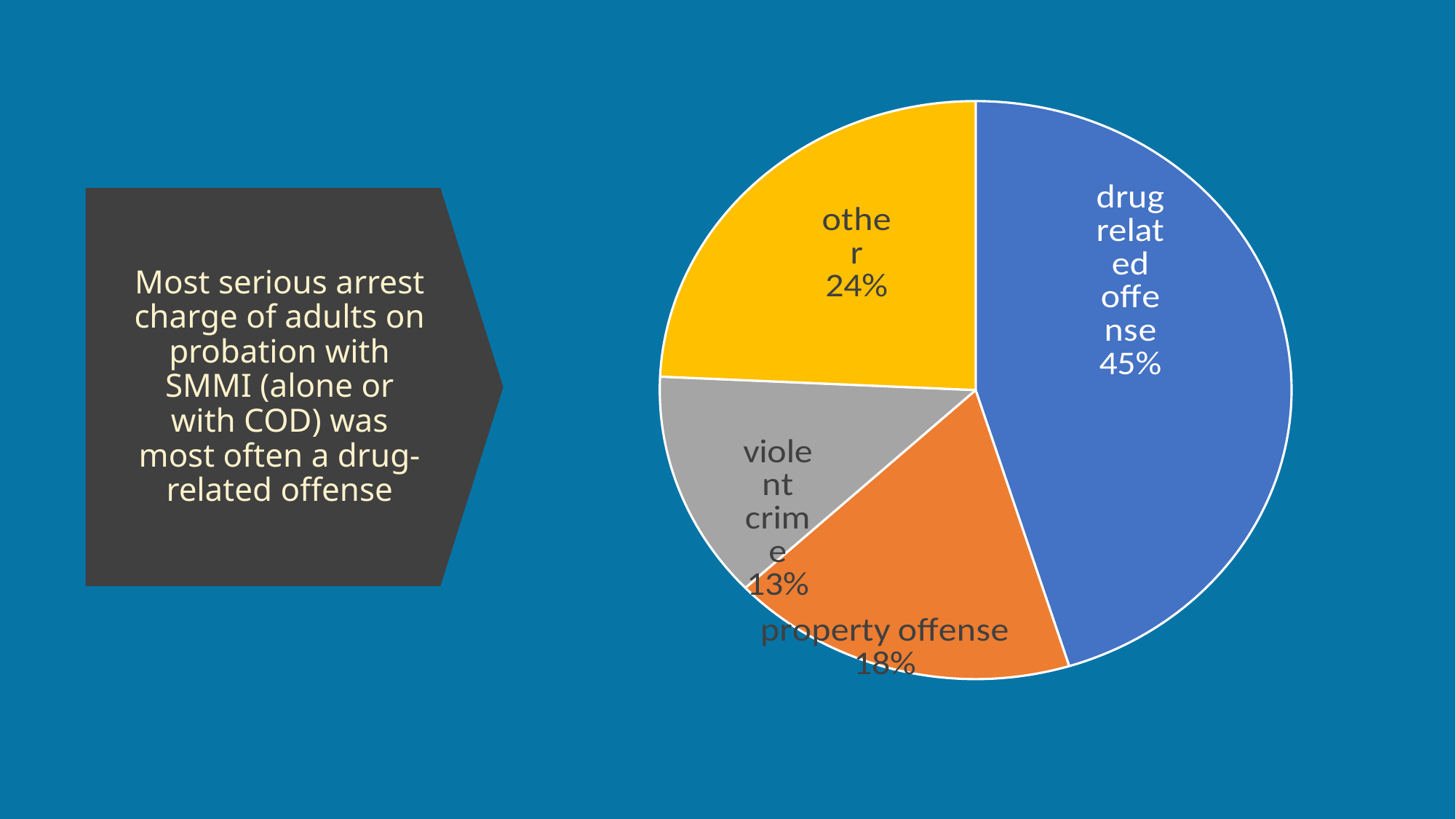
Which category has the smallest slice of the pie? violent crime What is the difference in percentage points between the drug related offense slice and the other slice? 21 What share of the pie does the violent crime slice represent? 13% What share of the pie does the other slice represent? 24% What colour is the drug related offense slice? blue What share of the pie does the property offense slice represent? 18% Which category has the largest slice of the pie? drug related offense How many slices does the pie chart have? 4 Which is larger, the other slice or the property offense slice? other What is the difference in percentage points between the property offense slice and the violent crime slice? 5 What kind of chart is shown on the slide? pie chart